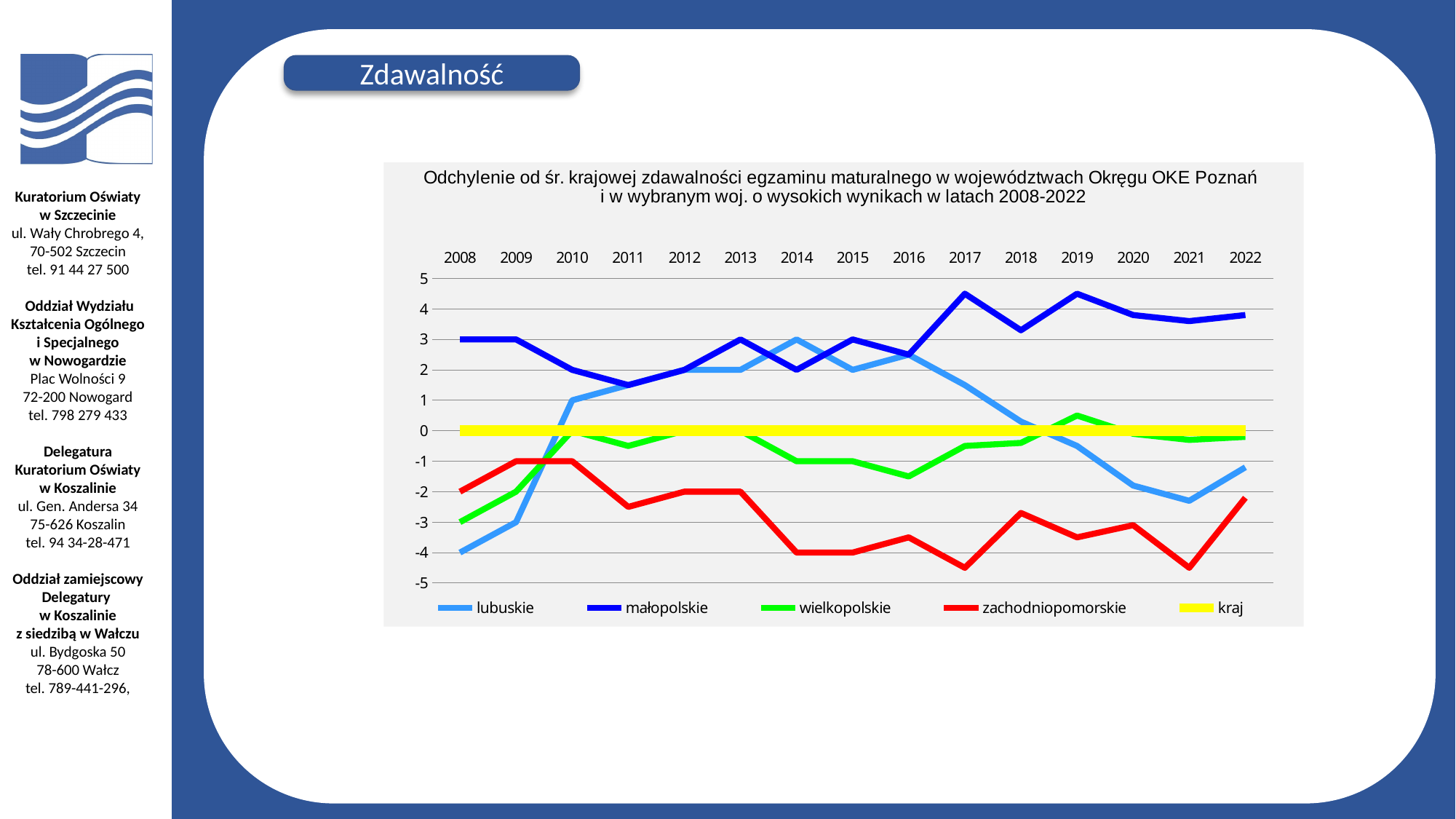
What kind of chart is shown on the slide? line chart In 2014, which is larger: the value for lubuskie or for małopolskie? lubuskie Which series has the lowest value in 2008? lubuskie Does the value for lubuskie rise or fall from 2014 to 2021? fall How many series does the legend list? 5 How many years are shown on the x axis? 15 Which series has the highest value in 2022? małopolskie Is the value for zachodniopomorskie in 2021 greater or less than -4? less What is the value for lubuskie in 2008? -4 What is the value for małopolskie in 2008? 3 Is the value for małopolskie in 2017 greater or less than 4? greater What is the value for zachodniopomorskie in 2014? -4